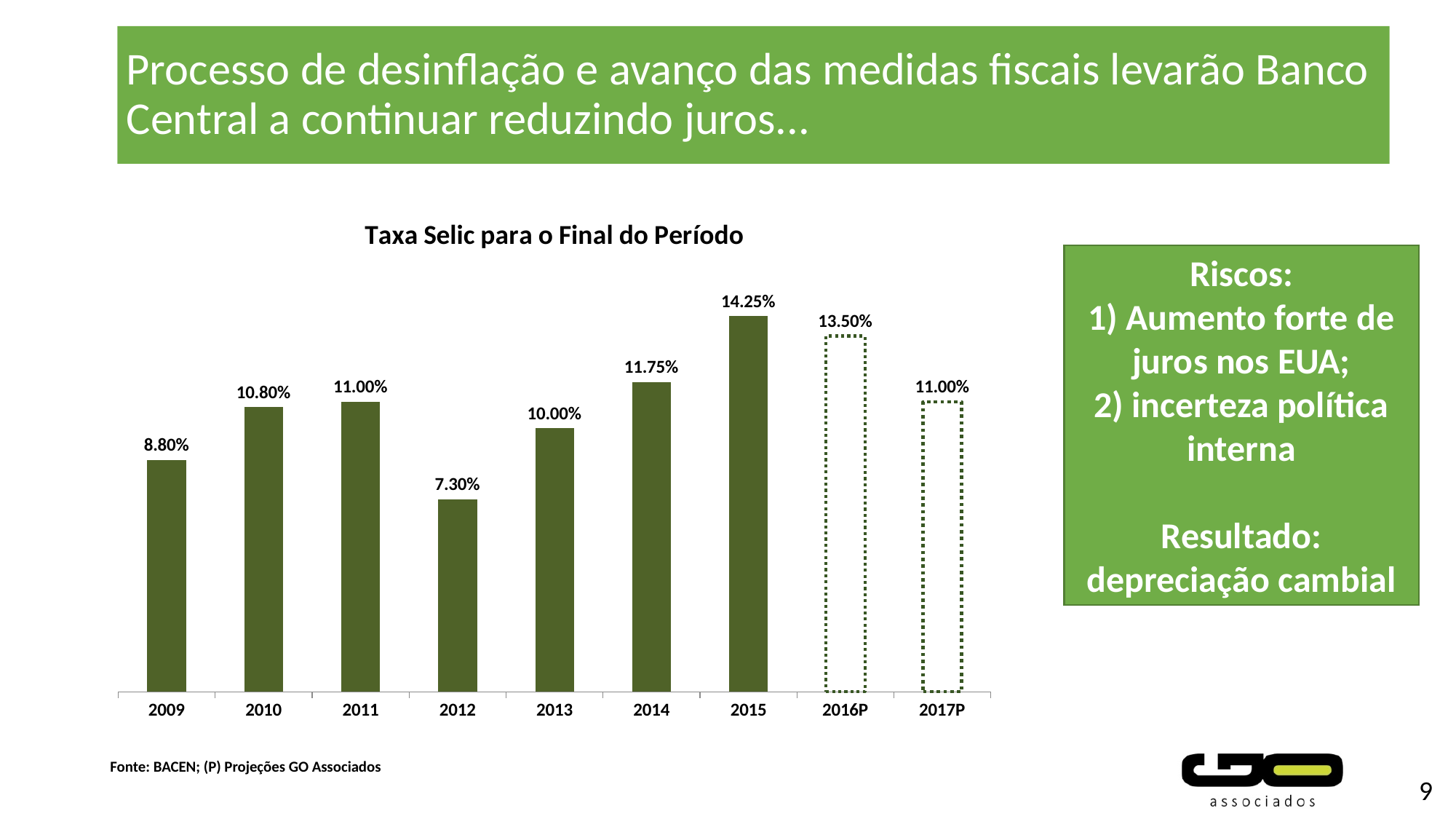
Which is larger, the Selic rate for 2010 or for 2011? 2011 Does the Selic rate rise or fall from 2015 to 2017P? Fall What is the Selic rate shown for 2012? 7.30% What kind of chart is shown on the slide? Bar chart What is the title of the chart? Taxa Selic para o Final do Período Which year has the highest Selic rate in the chart? 2015 What is the difference between the Selic rate in 2014 and in 2013? 1.75% Which year has the lowest Selic rate in the chart? 2012 How many years (categories) are shown on the x axis of the chart? 9 What is the Selic rate shown for 2016P? 13.50% What is the Selic rate shown for 2009? 8.80% What is the difference between the Selic rate in 2015 and in 2016P? 0.75%